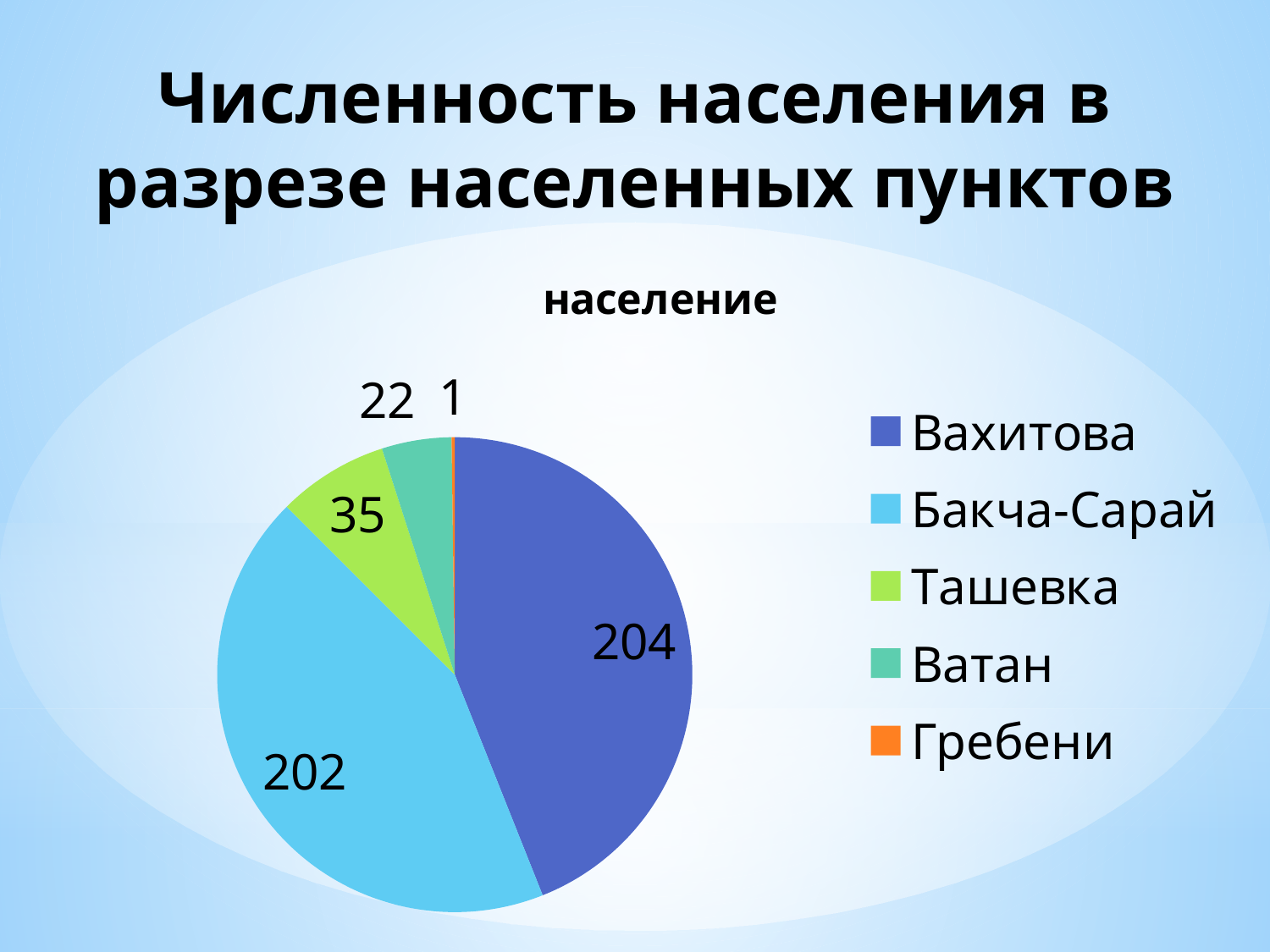
How many settlements are listed in the legend of the pie chart? 5 Which settlement has the largest population in the pie chart? Вахитова What is the population value for Ватан? 22 What is the population value for Ташевка? 35 What is the population value for Гребени? 1 What is the difference between the population of Ташевка and Ватан? 13 What kind of chart is shown on the slide? pie chart Which has a larger population, Ташевка or Ватан? Ташевка What is the population value for Вахитова? 204 Which settlement has the smallest population in the pie chart? Гребени What is the population value for Бакча-Сарай? 202 What is the title of the pie chart? население